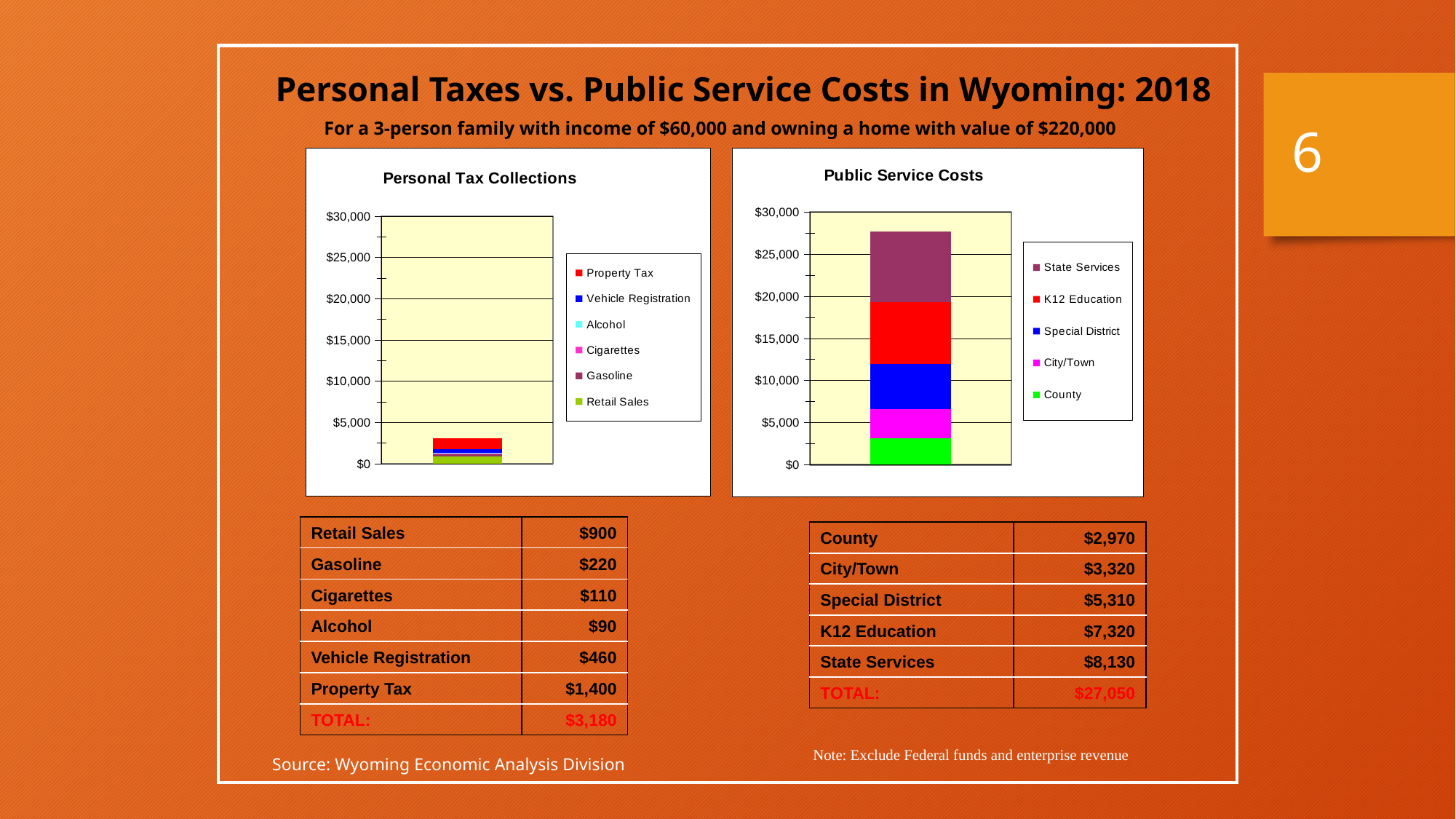
In the Personal Tax Collections chart, what is the value for Property Tax? $1,400 In the Personal Tax Collections chart, which series has the lowest value? Alcohol How many series does the legend of the Personal Tax Collections chart list? 6 In the Public Service Costs chart, which series has the highest value? State Services What is the total of the stacked bar in the Personal Tax Collections chart? $3,180 In the Public Service Costs chart, what is the difference between State Services and County? $5,160 In the Personal Tax Collections chart, which is larger, Vehicle Registration or Gasoline? Vehicle Registration How many series does the legend of the Public Service Costs chart list? 5 In the Public Service Costs chart, what is the value for K12 Education? $7,320 What kind of chart is the Public Service Costs chart? Stacked bar chart In the Public Service Costs chart, is the total height of the stacked bar greater or less than $25,000? greater In the Public Service Costs chart, what colour represents County? Green